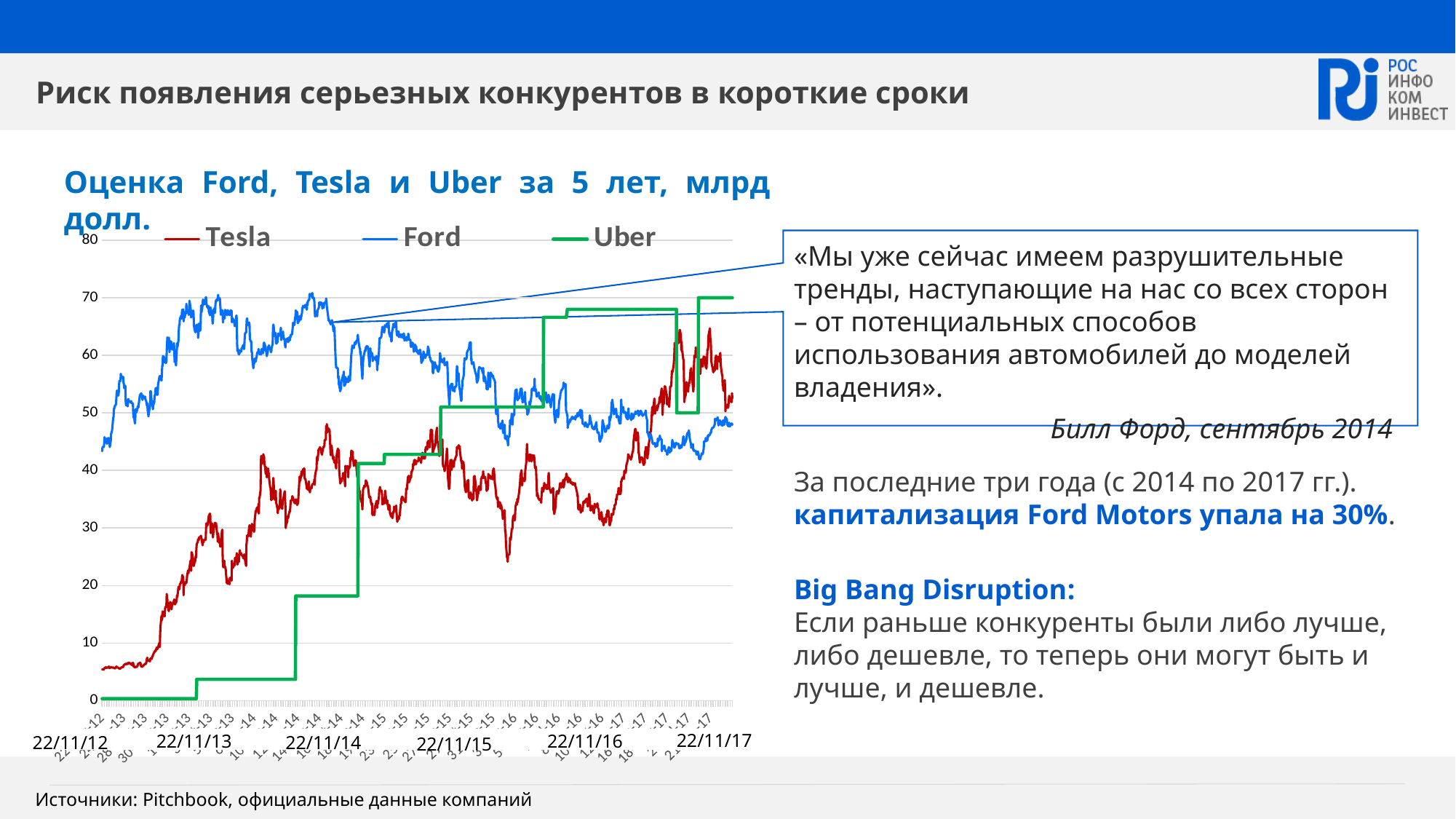
What kind of chart is shown on the slide? line chart Which series are listed in the chart legend? Tesla, Ford, Uber Which is larger at 22/11/13, the value for Ford or the value for Uber? Ford How many series does the chart legend list? 3 Which series has the highest value at the right end of the chart (22/11/17)? Uber Which is larger at 22/11/17, the value for Uber or the value for Ford? Uber Is the value for Uber at 22/11/12 greater or less than 10? less Is the value for Ford at 22/11/12 greater or less than 40? greater Is the value for Uber at 22/11/17 greater or less than 60? greater What colour is the Uber line in the chart? green Does the Uber line rise or fall from 22/11/12 to 22/11/17? rise